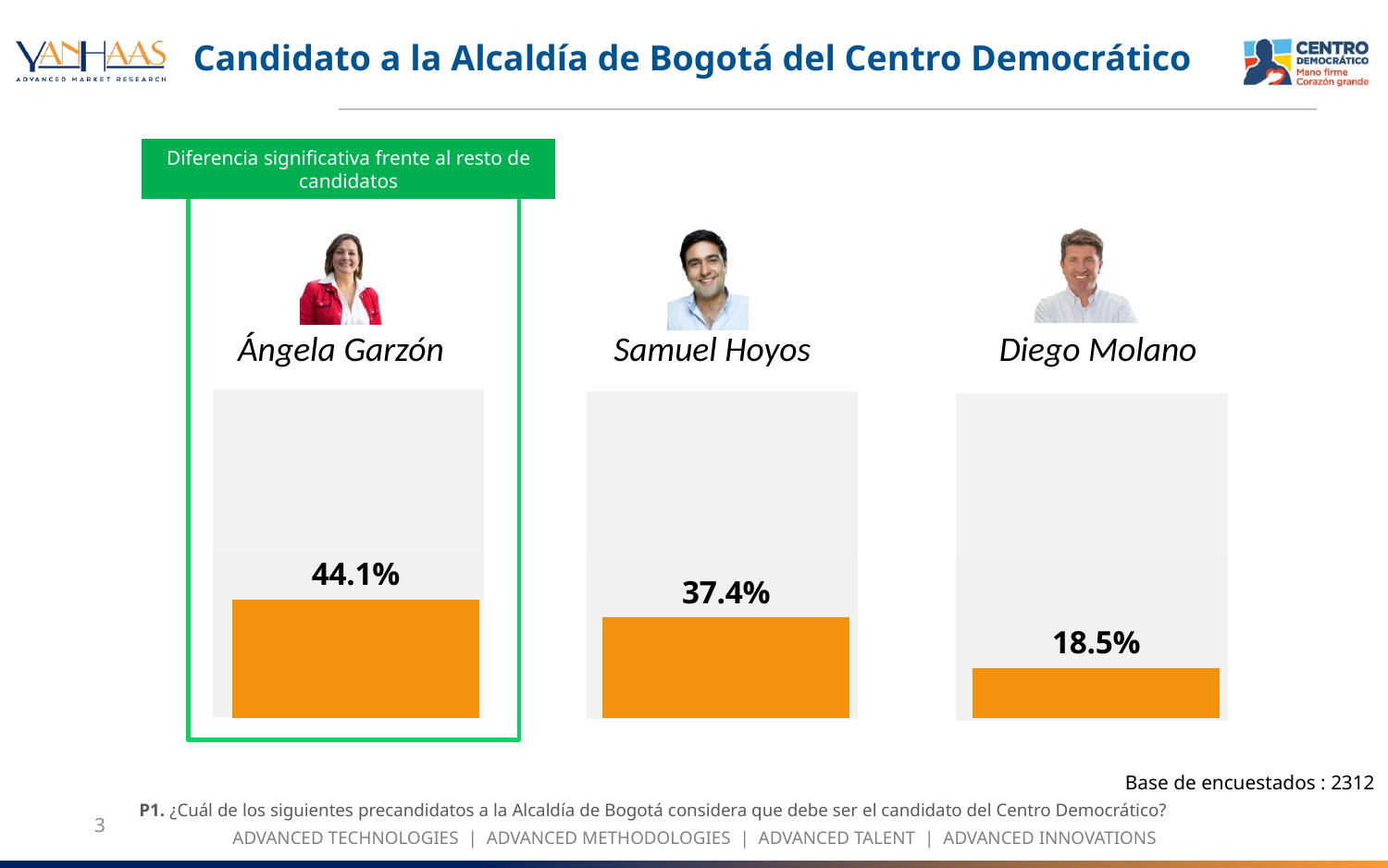
Which candidate has the highest percentage? Ángela Garzón What percentage is shown for Diego Molano? 18.5% Who has the larger percentage, Samuel Hoyos or Diego Molano? Samuel Hoyos What kind of chart is used to show the candidate percentages? Bar chart What is the difference in percentage points between Ángela Garzón and Samuel Hoyos? 6.7 What is the difference in percentage points between Samuel Hoyos and Diego Molano? 18.9 What percentage is shown for Samuel Hoyos? 37.4% Which candidate has the lowest percentage? Diego Molano How many candidates are shown in the chart? 3 Which candidate is highlighted with a green box labelled 'Diferencia significativa frente al resto de candidatos'? Ángela Garzón What percentage is shown for Ángela Garzón? 44.1% What is the total of the three candidate percentages? 100%